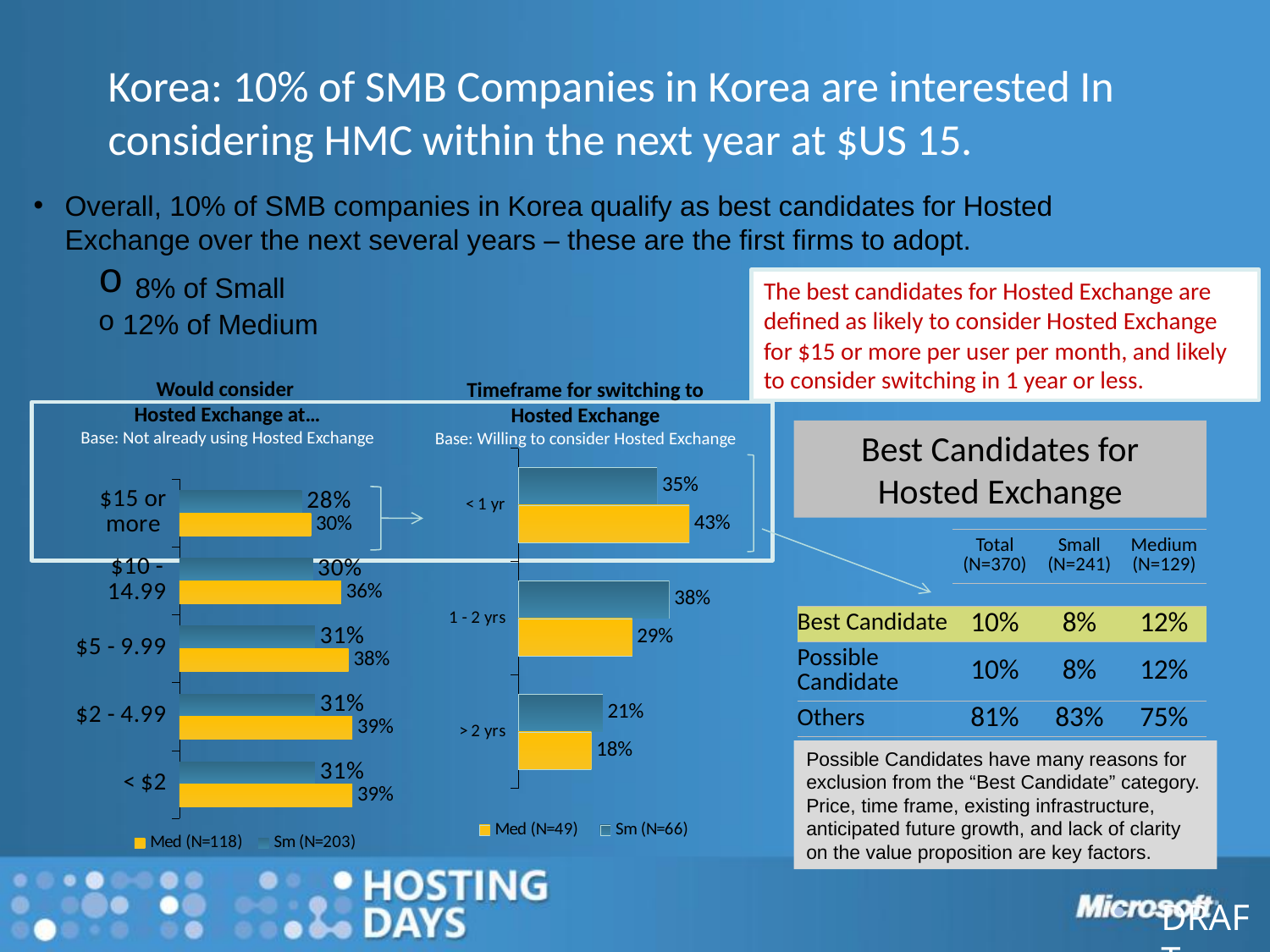
In the 'Timeframe for switching to Hosted Exchange' chart, what is the Sm (N=66) value for '1 - 2 yrs'? 38% In the 'Timeframe for switching to Hosted Exchange' chart, what is the difference between the Med (N=49) and Sm (N=66) values for '< 1 yr'? 8% In the 'Timeframe for switching to Hosted Exchange' chart, which timeframe has the highest Med (N=49) value? < 1 yr What type of chart is the 'Timeframe for switching to Hosted Exchange' chart? Bar chart In the 'Would consider Hosted Exchange at...' chart, what is the difference between the Med (N=118) and Sm (N=203) values for '$5 - 9.99'? 7% In the 'Would consider Hosted Exchange at...' chart, what is the Sm (N=203) value for '$10 - 14.99'? 30% In the 'Would consider Hosted Exchange at...' chart, how many price categories are shown? 5 In the 'Would consider Hosted Exchange at...' chart, which price category has the lowest Med (N=118) value? $15 or more In the 'Timeframe for switching to Hosted Exchange' chart, is the Sm (N=66) value for '> 2 yrs' larger or smaller than the Med (N=49) value for '> 2 yrs'? larger In the 'Timeframe for switching to Hosted Exchange' chart, what is the Med (N=49) value for '< 1 yr'? 43% In the 'Would consider Hosted Exchange at...' chart, what is the Med (N=118) value for '$15 or more'? 30% In the 'Would consider Hosted Exchange at...' chart, how many series does the legend list? 2